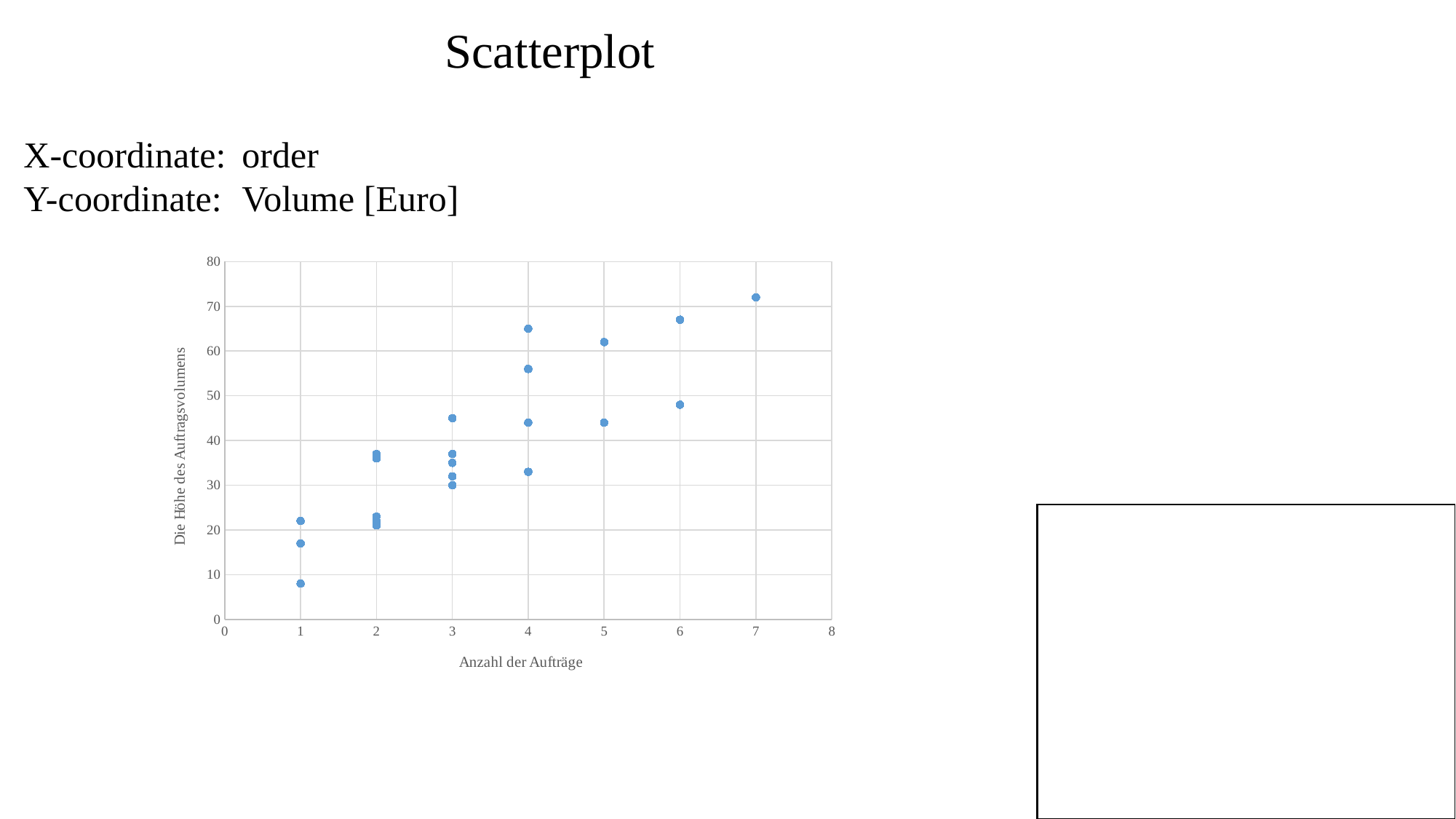
What is the maximum value shown on the y axis of the chart? 80 What is the title of the x axis of the chart? Anzahl der Aufträge How many distinct x values (Anzahl der Aufträge) have points plotted on the chart? 7 Is the highest point at x = 4 greater or less than 60? greater Is the lowest point at x = 2 greater or less than 30? less At which x value (Anzahl der Aufträge) does the highest point on the chart appear? 7 At which x value (Anzahl der Aufträge) does the lowest point on the chart appear? 1 Is the value of the point at x = 7 greater or less than 60? greater What kind of chart is shown on the slide? scatter plot Do the plotted volumes generally rise or fall as the number of orders increases along the x axis? rise